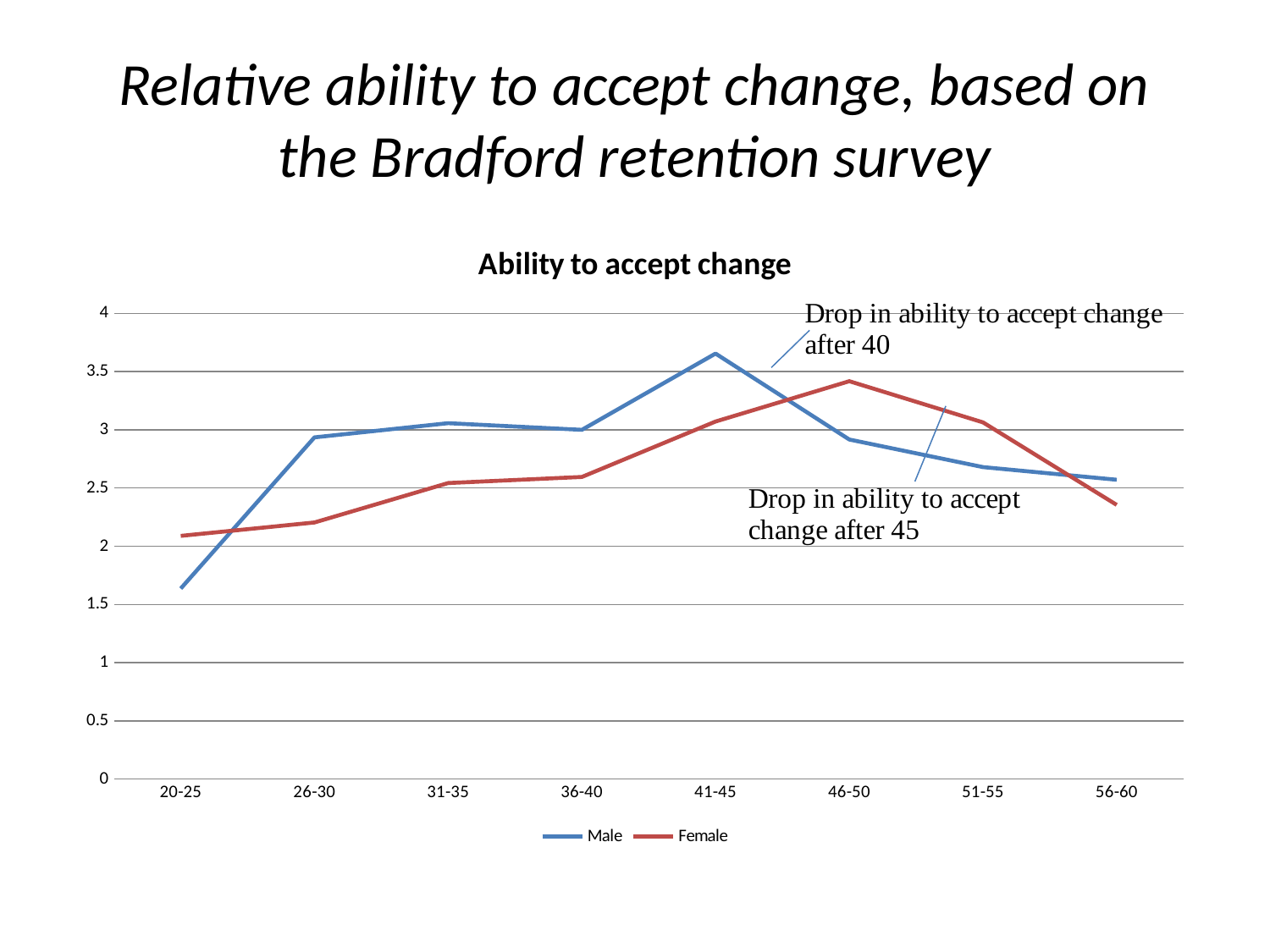
What kind of chart is shown on the slide? line chart In which age group does the Female series reach its highest value? 46-50 At 46-50, which series has the larger value, Male or Female? Female Is the Male value for 41-45 greater or less than 3.5? greater In which age group is the Male series at its lowest value? 20-25 Is the Female value for 46-50 greater or less than 3? greater Does the Male series rise or fall from 41-45 to 56-60? fall How many age groups are shown on the x axis? 8 How many series does the legend list? 2 In which age group does the Male series reach its highest value? 41-45 Is the Male value for 20-25 greater or less than 2? less At 26-30, which series has the larger value, Male or Female? Male